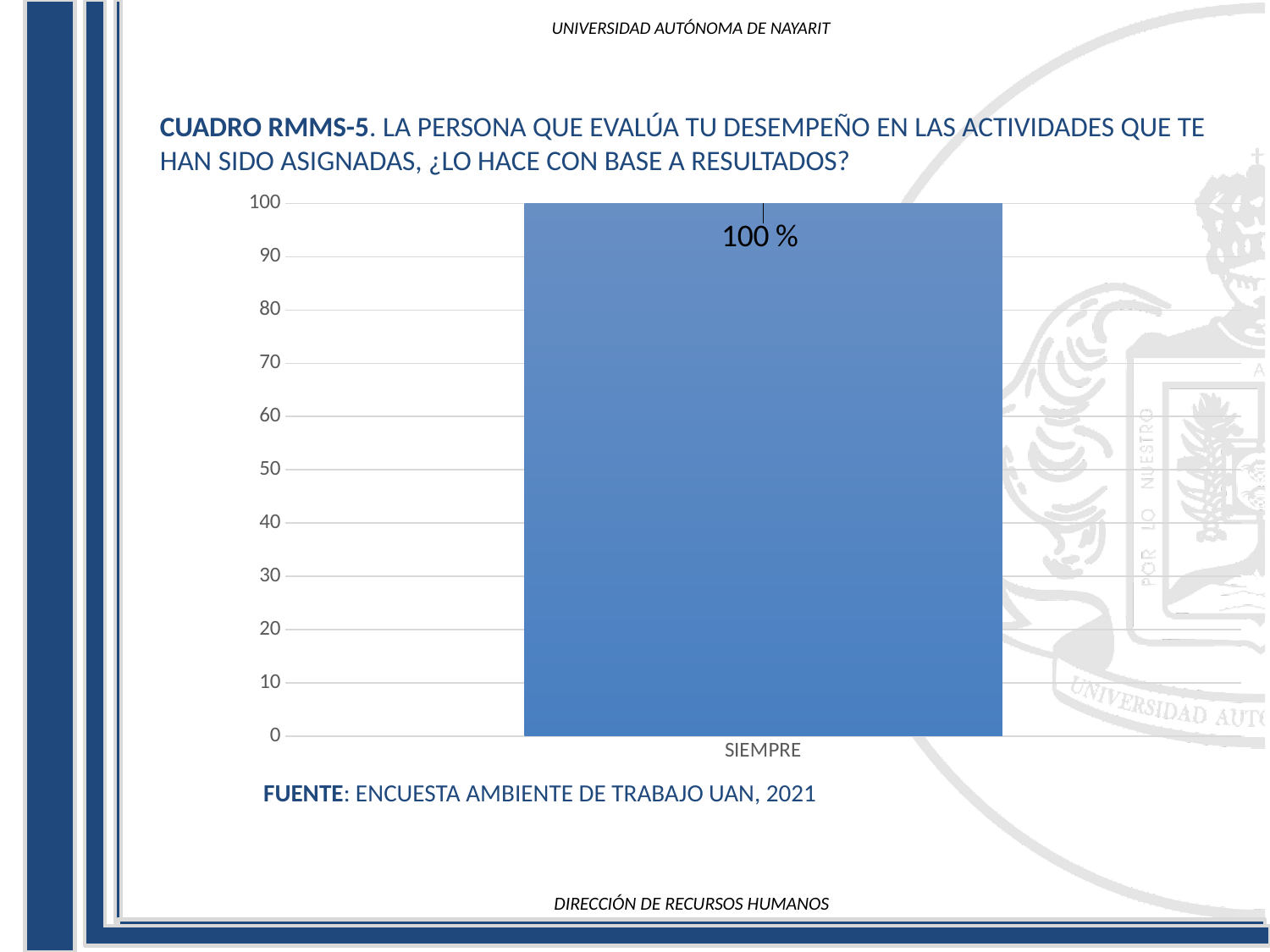
What is the label of the only category on the x axis? SIEMPRE How many categories are plotted on the x axis of the chart? 1 What is the value shown for the SIEMPRE bar? 100 % What kind of chart is shown on the slide? bar chart What is the highest value shown on the vertical axis of the chart? 100 Is the value for SIEMPRE greater or less than 50? greater